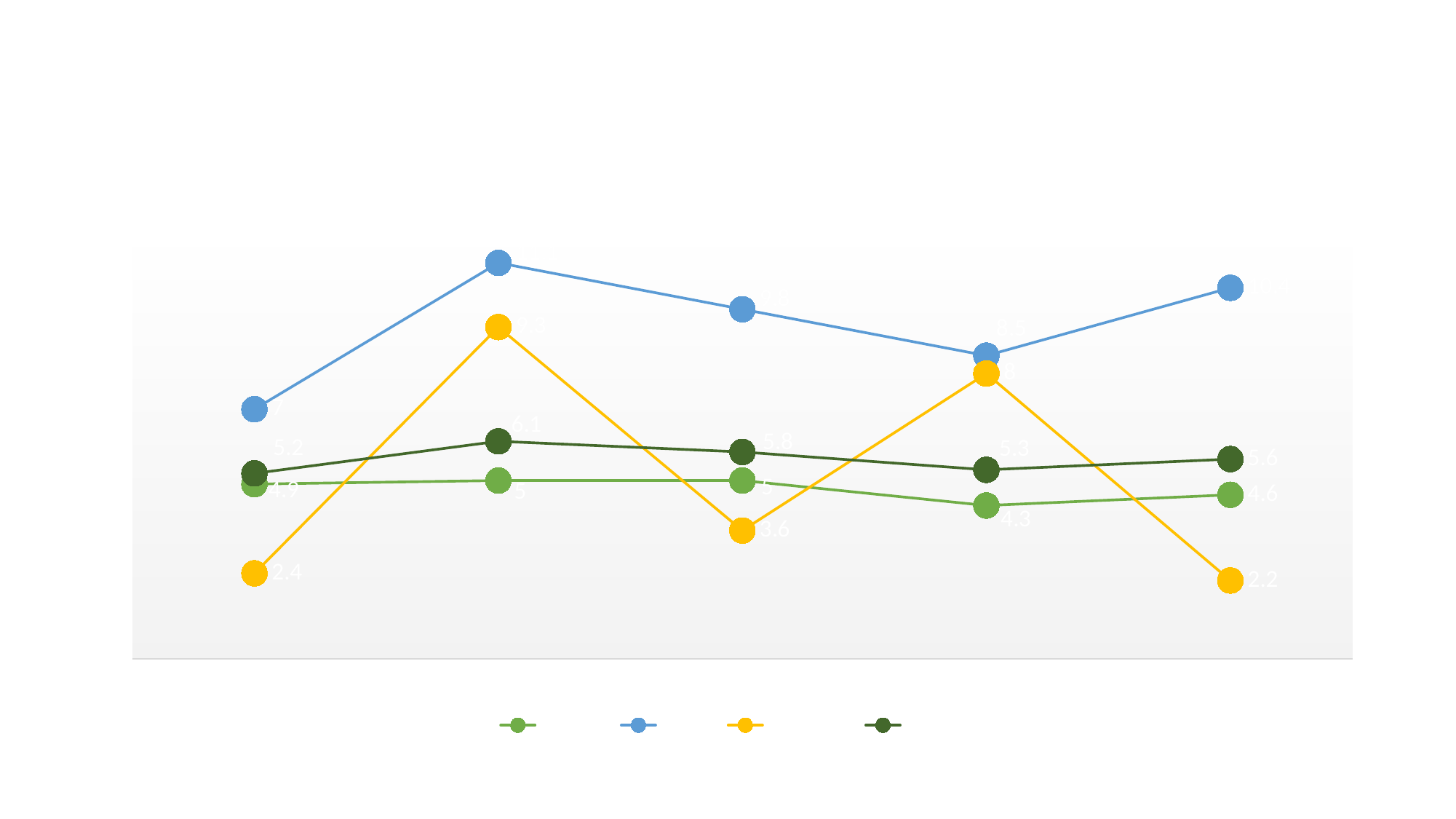
At the first point, which is larger: the dark green line or the light green line? the dark green line What is the value of the second point on the dark green line? 6.1 What is the value of the last point on the yellow line? 2.2 How many data points does each line have? 5 How many series does the legend list? 4 What is the difference between the second and first points on the dark green line? 0.9 What is the value of the first point on the yellow line? 2.4 Which point on the light green line is the lowest? the fourth point (4.3) What kind of chart is shown on the slide? line chart Does the blue line rise or fall from its second point to its fourth point? fall Which line has the highest values across the chart? the blue line What is the value of the fourth point on the light green line? 4.3